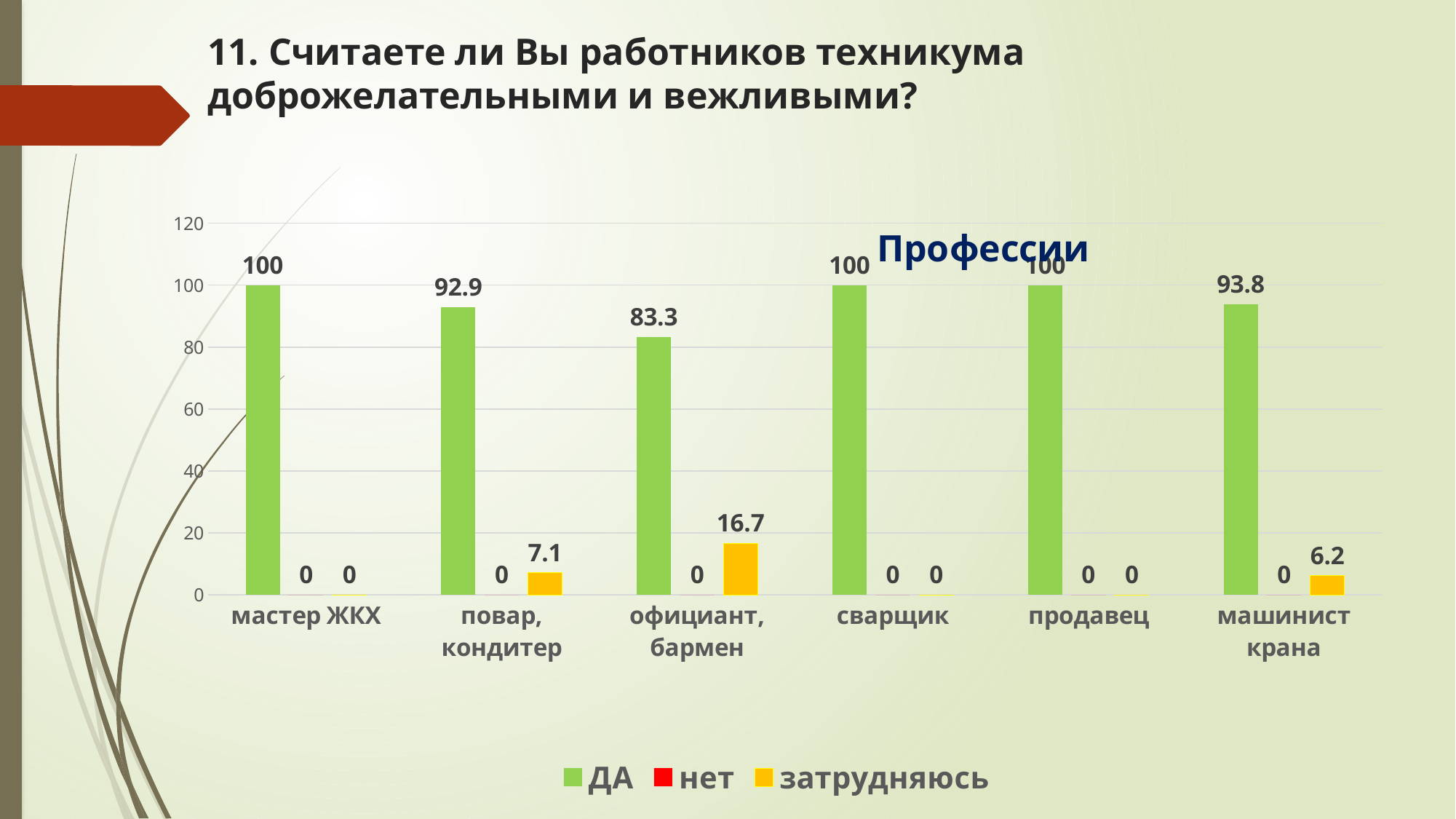
Which is larger, the ДА value for повар, кондитер or for машинист крана? машинист крана What is the value of затрудняюсь for повар, кондитер? 7.1 What is the value of нет for сварщик? 0 Which category has the highest затрудняюсь value? официант, бармен What is the value of ДА for официант, бармен? 83.3 What is the value of ДА for машинист крана? 93.8 What is the difference between the ДА values for повар, кондитер and официант, бармен? 9.6 Which category has the lowest ДА value? официант, бармен How many series does the legend list? 3 How many categories are shown on the x axis? 6 What is the value of затрудняюсь for официант, бармен? 16.7 What kind of chart is shown on the slide? bar chart